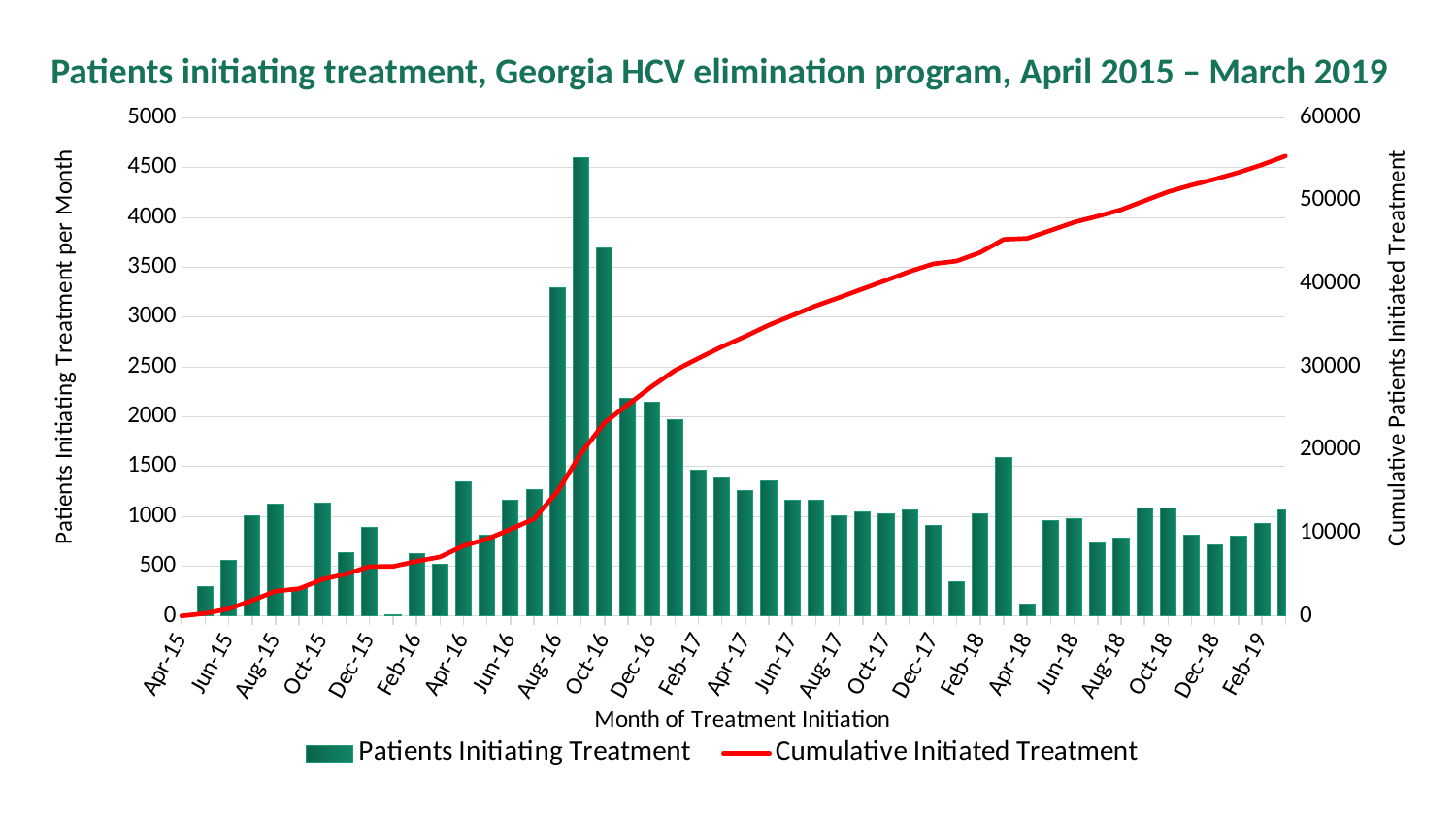
What are the two series listed in the legend? Patients Initiating Treatment; Cumulative Initiated Treatment Does the Cumulative Initiated Treatment line rise or fall from Apr-15 to Feb-19? Rise Is the tallest Patients Initiating Treatment bar greater or less than 4000? greater Is the Patients Initiating Treatment value for Dec-15 greater or less than 1000? less What is the label of the right-hand vertical axis? Cumulative Patients Initiated Treatment Is the Cumulative Initiated Treatment value at Oct-15 greater or less than 10000? less How many series does the legend list? 2 What kind of chart is shown on the slide? A bar chart combined with a line chart Which month has the higher Patients Initiating Treatment bar, Aug-16 or Oct-16? Oct-16